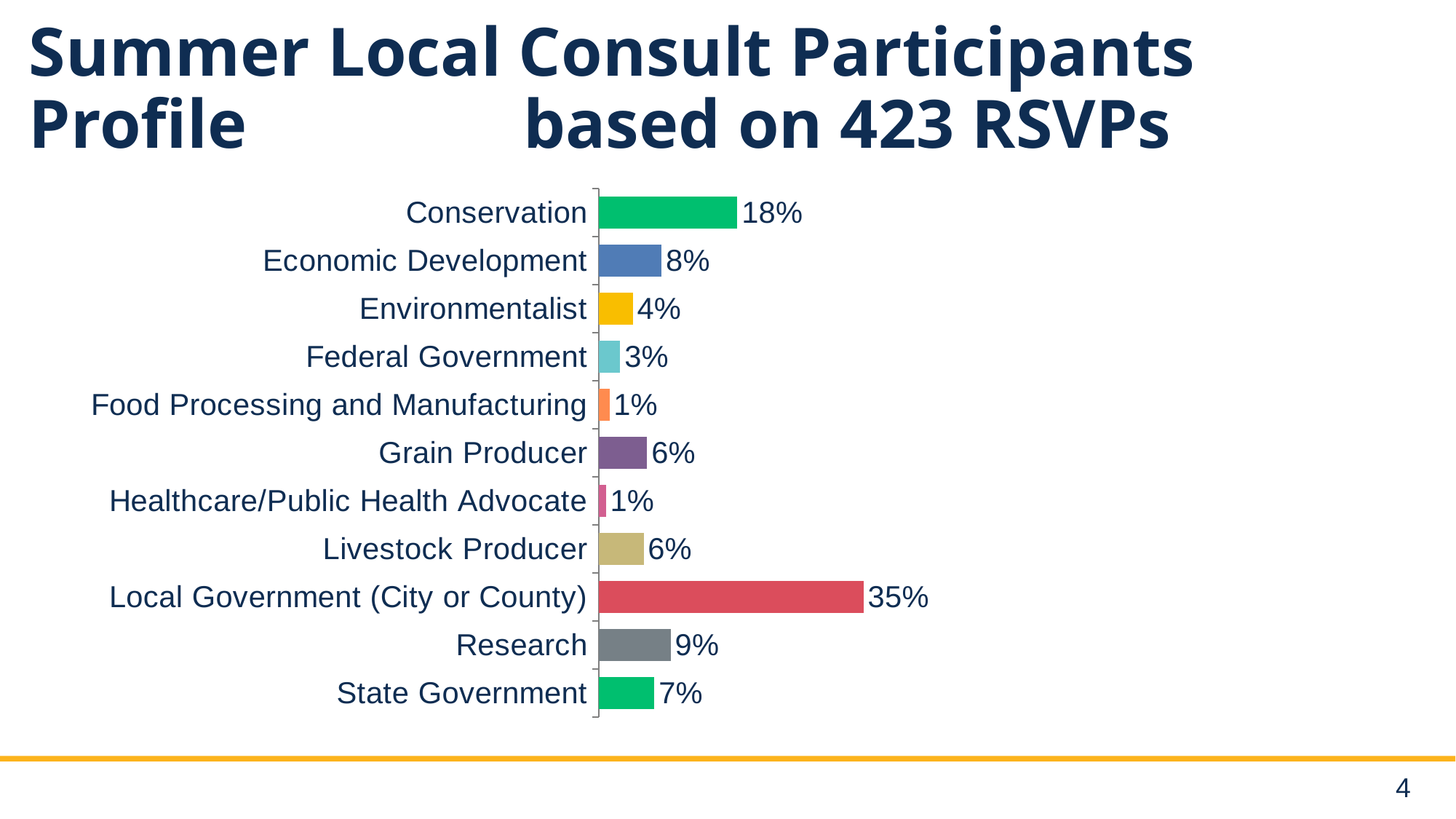
What is the difference between the Research value and the Economic Development value? 1% What is the value for Research? 9% How many categories are shown in the chart? 11 What is the difference between the Local Government (City or County) value and the Conservation value? 17% What percentage of participants are Grain Producers? 6% Which category has the highest share of participants? Local Government (City or County) What percentage of participants are from Local Government (City or County)? 35% Which is larger, Environmentalist or Federal Government? Environmentalist What kind of chart is shown on the slide? Bar chart What is the value shown for Conservation? 18% Which is larger, Economic Development or State Government? Economic Development How many RSVPs is the participant profile based on, according to the slide title? 423